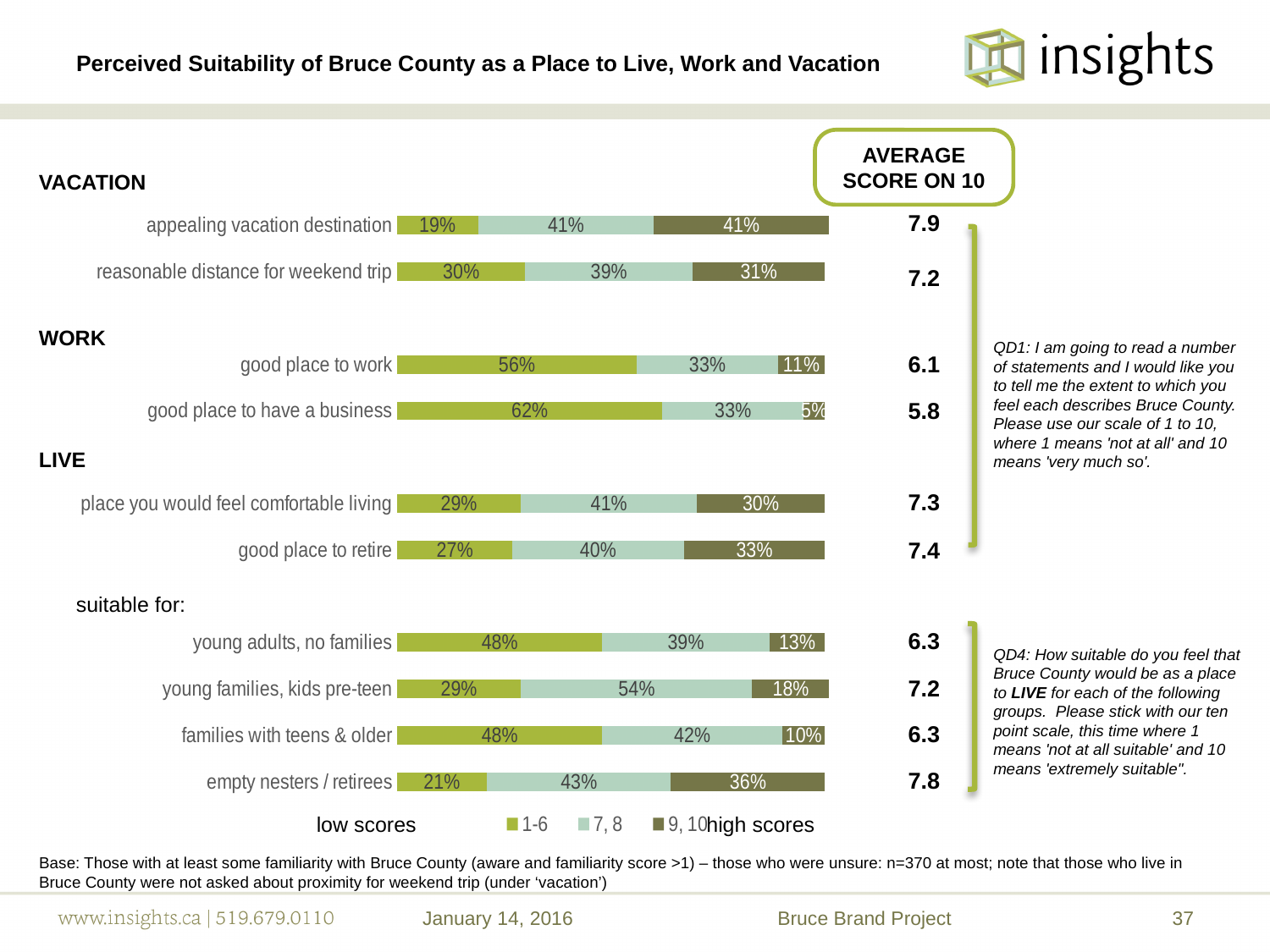
What percentage gave a score of 1-6 for 'good place to have a business'? 62% What kind of chart is shown on the slide? stacked bar chart Which statement has the lowest average score on 10? good place to have a business How many series does the legend list? 3 What is the difference between the 1-6 percentages for 'good place to have a business' and 'good place to work'? 6% How many statements (bars) are plotted in the chart? 10 Which has a larger 9, 10 percentage: 'empty nesters / retirees' or 'young adults, no families'? empty nesters / retirees Which statement has the highest average score on 10? appealing vacation destination What percentage gave a score of 9 or 10 for 'appealing vacation destination'? 41% What is the average score on 10 for 'good place to retire'? 7.4 What is the total of the three segments for the 'reasonable distance for weekend trip' bar? 100% What percentage gave a score of 7 or 8 for 'young families, kids pre-teen'? 54%